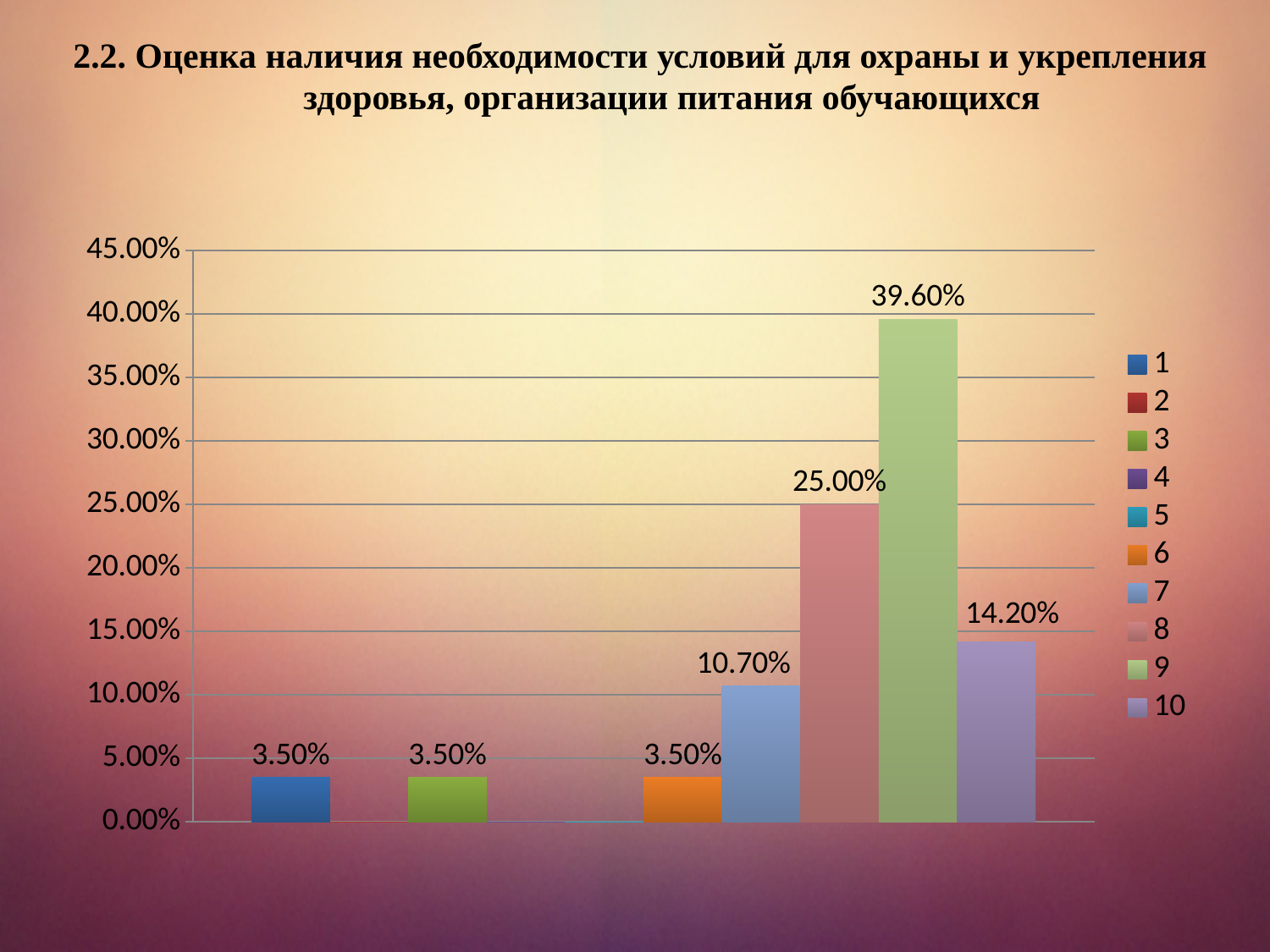
What is the value for series 1? 3.50% Which series has the highest value? 9 What is the value for series 9? 39.60% What is the value for series 8? 25.00% What kind of chart is shown on the slide? bar chart Which is larger, the value for series 8 or the value for series 10? series 8 What is the value for series 10? 14.20% Is the value for series 9 greater or less than 35.00%? greater What is the difference between the values for series 9 and series 8? 14.60% How many series does the legend list? 10 What is the value for series 7? 10.70% What is the difference between the values for series 10 and series 7? 3.50%